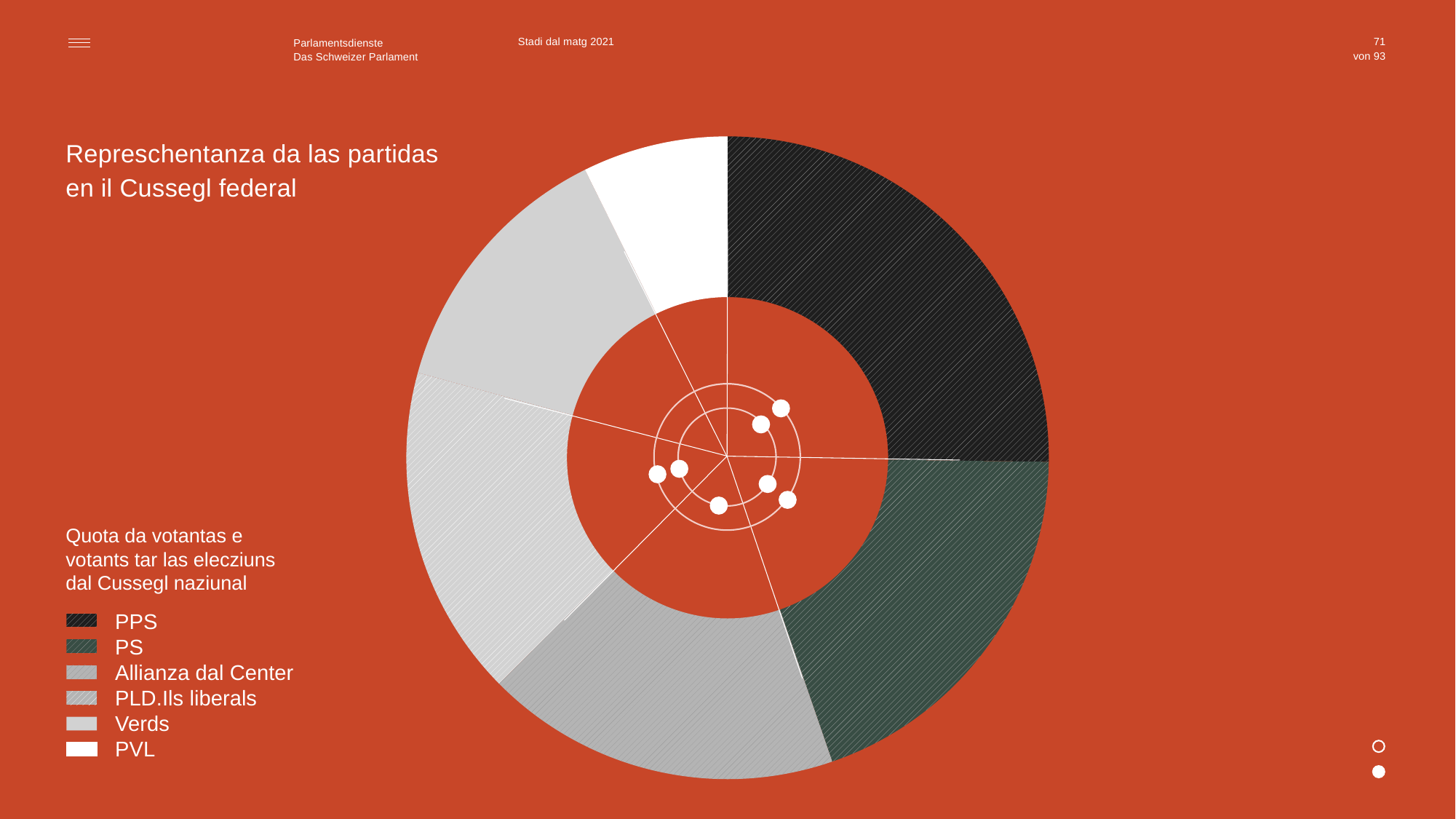
Which slice is larger, PPS or PS? PPS Which party has the smallest slice of the chart? PVL Which party has the largest slice of the chart? PPS Which party is shown in white in the legend? PVL Which slice is larger, Verds or PVL? Verds How many entries does the legend list? 6 Which slice is larger, PPS or PVL? PPS What is the title of the chart? Represchentanza da las partidas en il Cussegl federal How many parties (categories) does the chart show? 6 What kind of chart is shown on the slide? Doughnut chart